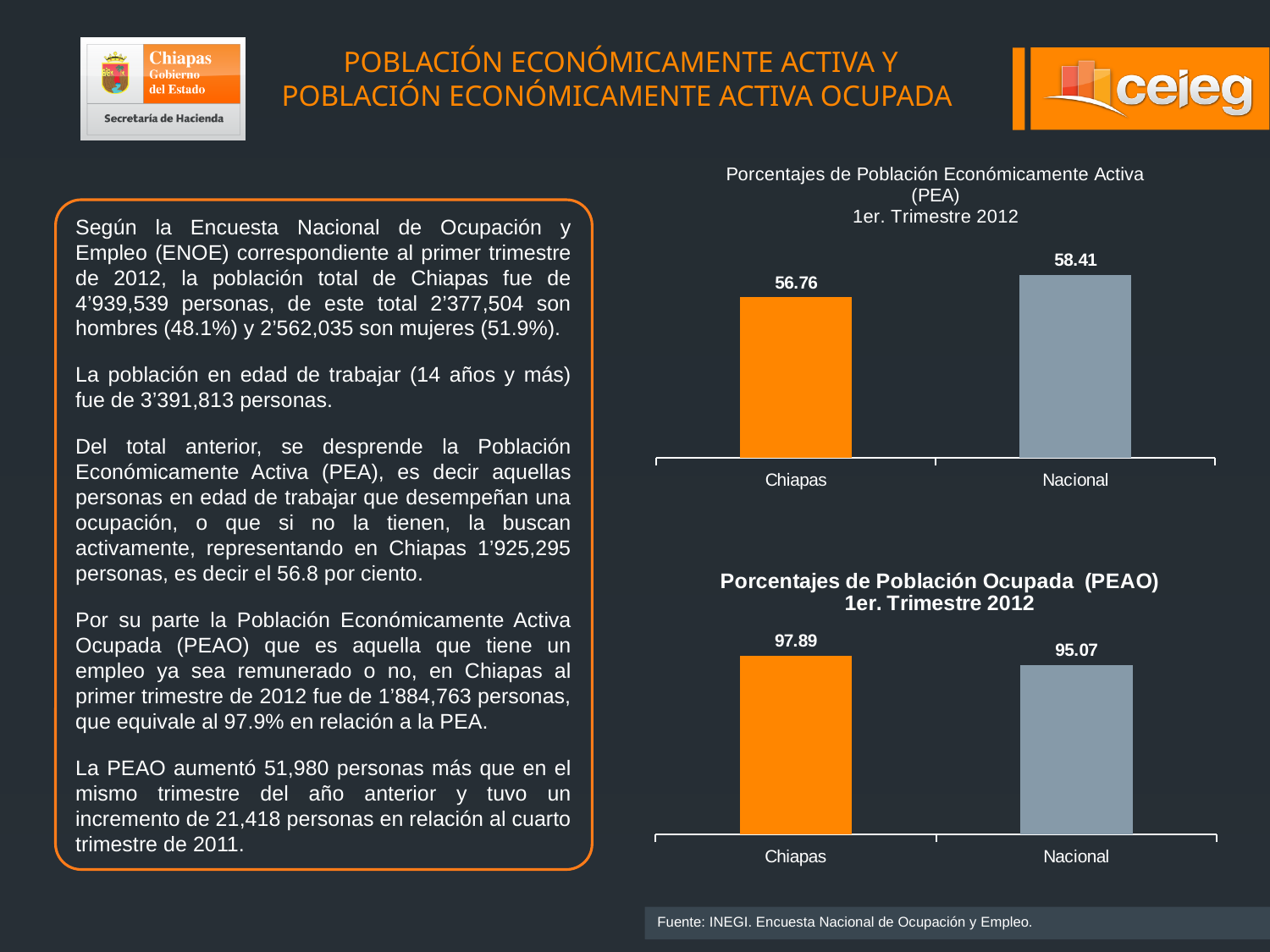
In the bottom chart (PEAO), what is the difference between the Chiapas and Nacional values? 2.82 In the bottom chart (Porcentajes de Población Ocupada (PEAO) 1er. Trimestre 2012), what is the value for Chiapas? 97.89 In the bottom chart (PEAO), is the value for Chiapas larger or smaller than the value for Nacional? larger In the top chart (PEA), what colour is the bar for Chiapas? orange In the bottom chart (PEAO), what is the value for Nacional? 95.07 In the top chart (PEA), which category has the higher value? Nacional How many categories are shown in the top chart (PEA)? 2 In the top chart (PEA), what is the value for Nacional? 58.41 In the top chart (Porcentajes de Población Económicamente Activa (PEA) 1er. Trimestre 2012), what is the value for Chiapas? 56.76 In the top chart (PEA), what is the difference between the Nacional and Chiapas values? 1.65 What type of chart is the bottom chart (PEAO)? bar chart In the bottom chart (PEAO), which category has the lower value? Nacional